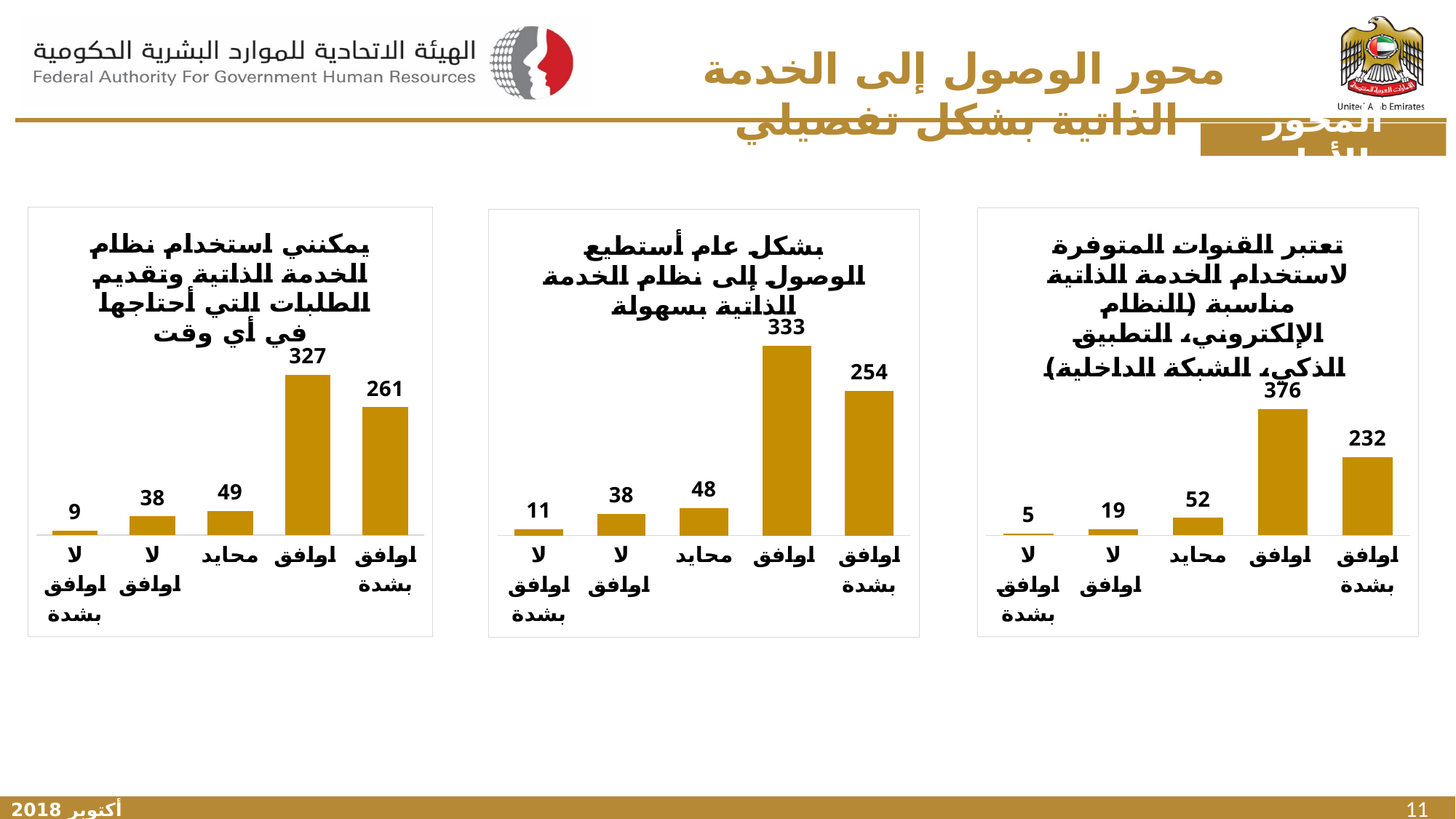
In the right chart, what is the total of the values for "لا اوافق بشدة" and "لا اوافق"? 24 In the middle chart, which category has the lowest value? لا اوافق بشدة (strongly disagree) What colour are the bars in the three charts? Gold What kind of chart is the middle chart? Bar chart How many categories are shown in the left chart? 5 In the right chart, what is the difference between the values for "اوافق" and "اوافق بشدة"? 144 In the middle chart, what is the value for "اوافق بشدة" (strongly agree)? 254 In the right chart, what is the value for "محايد" (neutral)? 52 In the left chart, what is the value for "اوافق" (agree)? 327 In the middle chart, which is larger: the value for "محايد" or the value for "لا اوافق"? محايد (neutral) In the left chart, what is the difference between the values for "اوافق" and "اوافق بشدة"? 66 In the right chart, which category has the highest value? اوافق (agree)